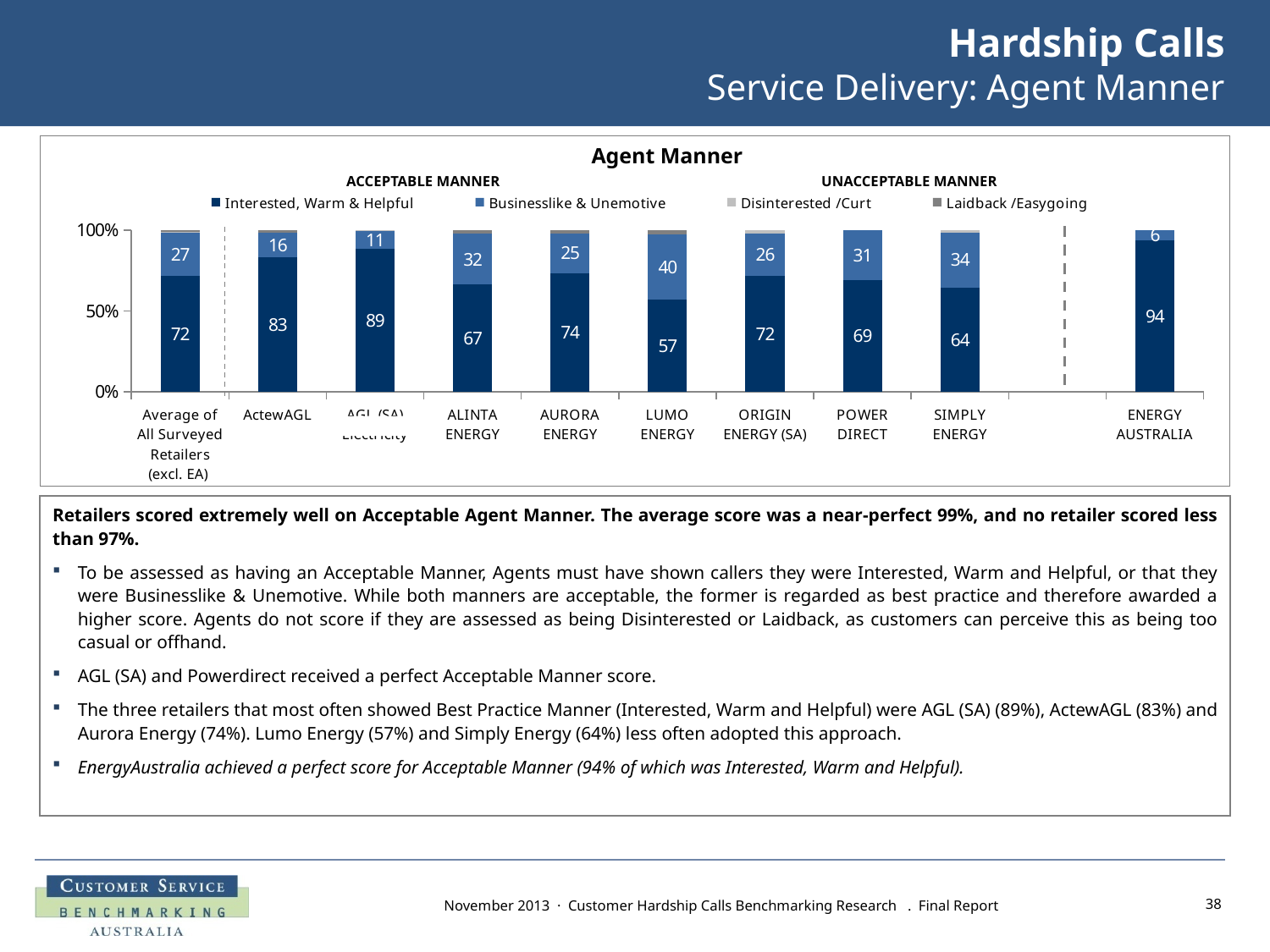
What is the Interested, Warm & Helpful value for ENERGY AUSTRALIA? 94 Which retailer has the highest Interested, Warm & Helpful value? ENERGY AUSTRALIA What is the Businesslike & Unemotive value for SIMPLY ENERGY? 34 What is the Interested, Warm & Helpful value for the Average of All Surveyed Retailers (excl. EA)? 72 Which has a larger Interested, Warm & Helpful value, ALINTA ENERGY or POWER DIRECT? POWER DIRECT What is the difference between the Interested, Warm & Helpful values for ActewAGL and AURORA ENERGY? 9 Which retailer has the highest Businesslike & Unemotive value? LUMO ENERGY What is the combined value of Interested, Warm & Helpful and Businesslike & Unemotive for LUMO ENERGY? 97 What kind of chart is shown on the slide? Stacked bar chart What is the Interested, Warm & Helpful value for LUMO ENERGY? 57 How many series does the legend list? 4 Which retailer has the lowest Interested, Warm & Helpful value? LUMO ENERGY